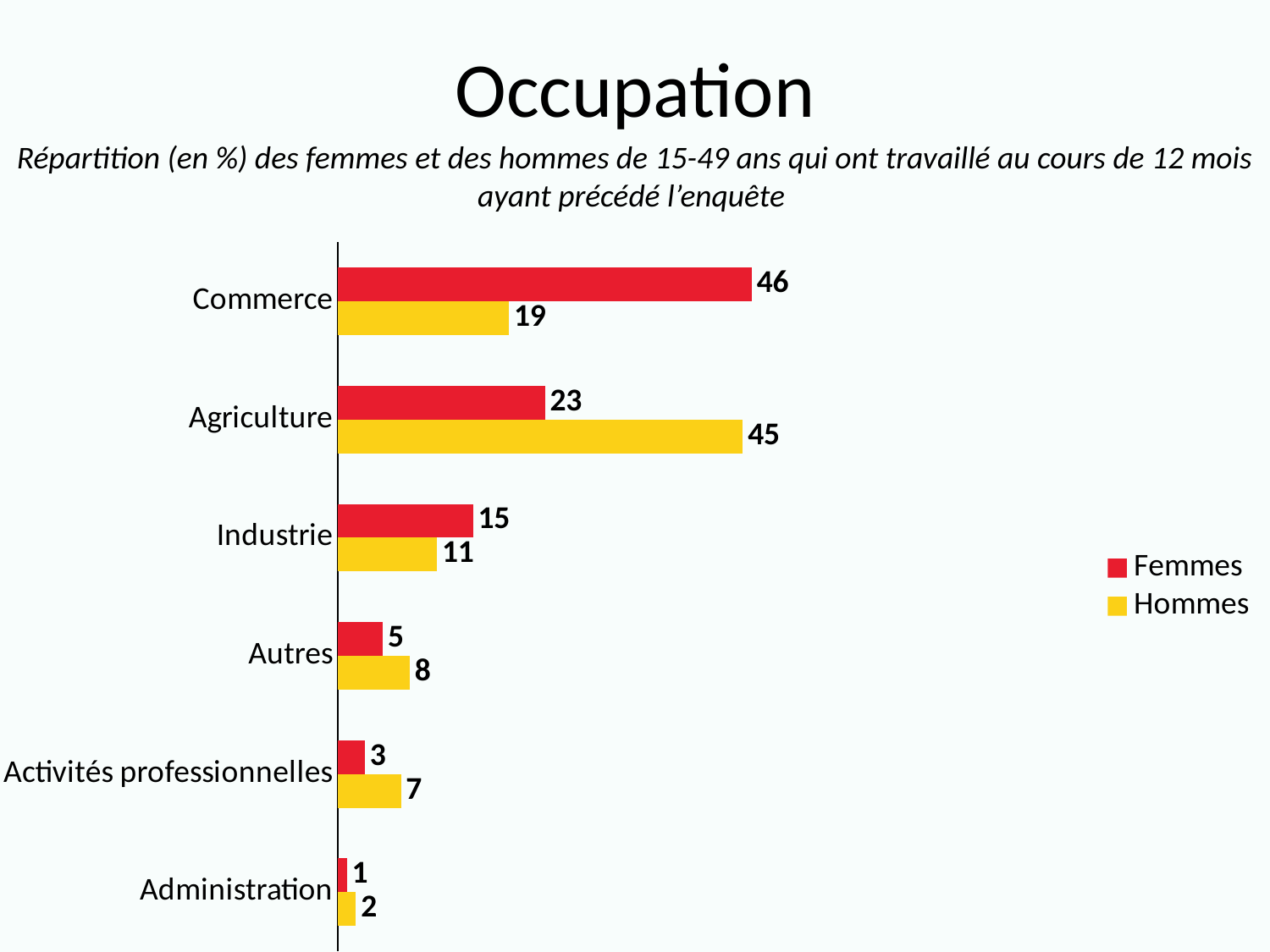
Which colour represents the Hommes series? Yellow What is the difference between the Femmes and Hommes values for Commerce? 27 Which category has the highest value for Femmes? Commerce How many series does the legend list? 2 Which category has the lowest value for Hommes? Administration What kind of chart is shown on the slide? Bar chart What is the value for Hommes in the Agriculture category? 45 What is the value for Femmes in the Commerce category? 46 How many categories are shown on the chart? 6 What is the value for Hommes in the Industrie category? 11 What is the difference between the Hommes and Femmes values for Agriculture? 22 Which is larger for Autres, the Femmes value or the Hommes value? Hommes